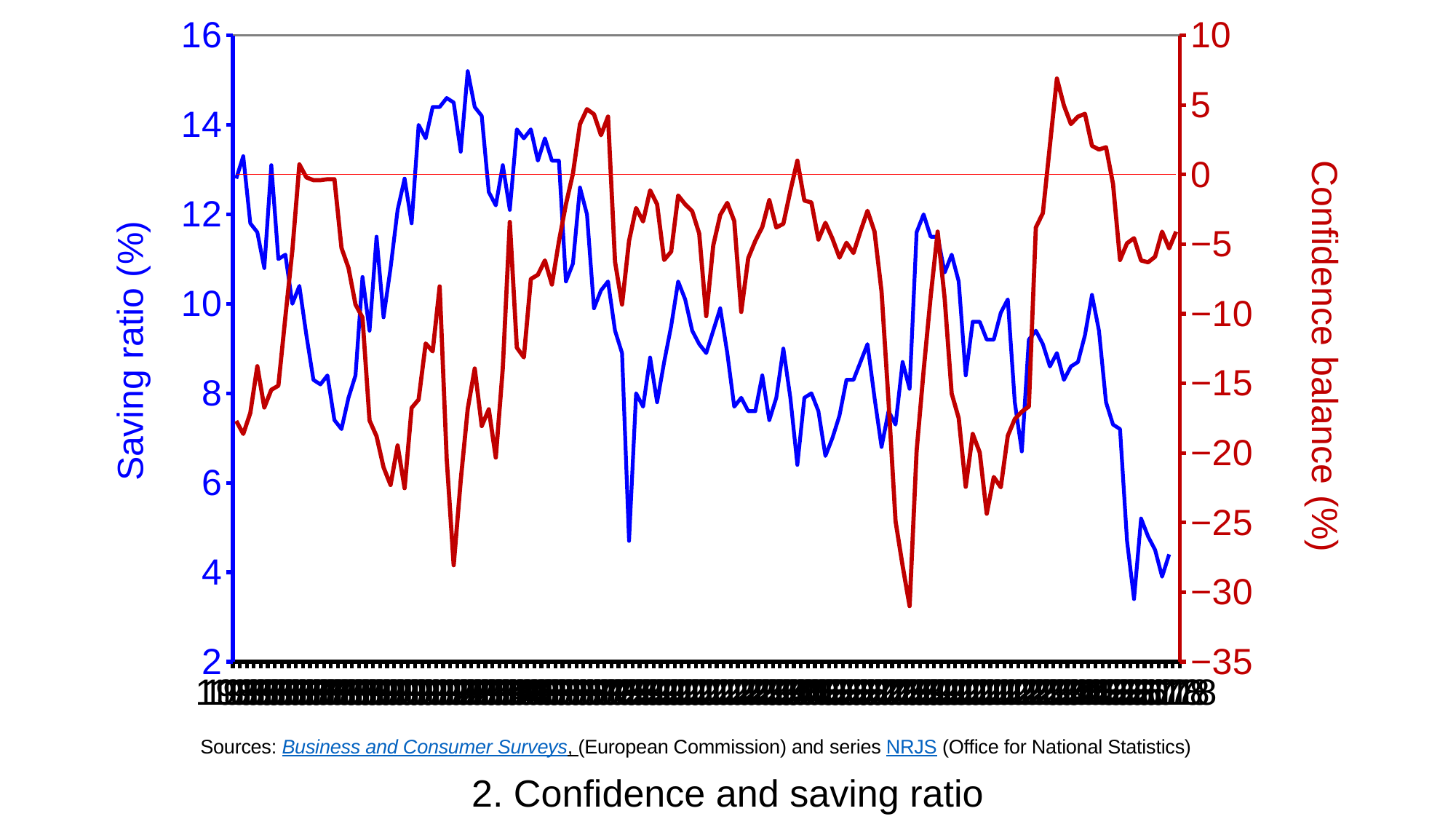
Does the confidence balance line end higher or lower than it starts at the left of the chart? higher Is the lowest value reached by the saving ratio line greater or less than 4? less How many data series are plotted on the chart? 2 Does the saving ratio line end higher or lower than it starts at the left of the chart? lower Is the lowest value reached by the confidence balance line greater or less than -25? less Is the highest value reached by the saving ratio line greater or less than 14? greater What colour is the line for the saving ratio? blue Over the final portion of the chart, does the saving ratio rise or fall? fall What kind of chart is shown on the slide? line chart What is the title of the chart? 2. Confidence and saving ratio